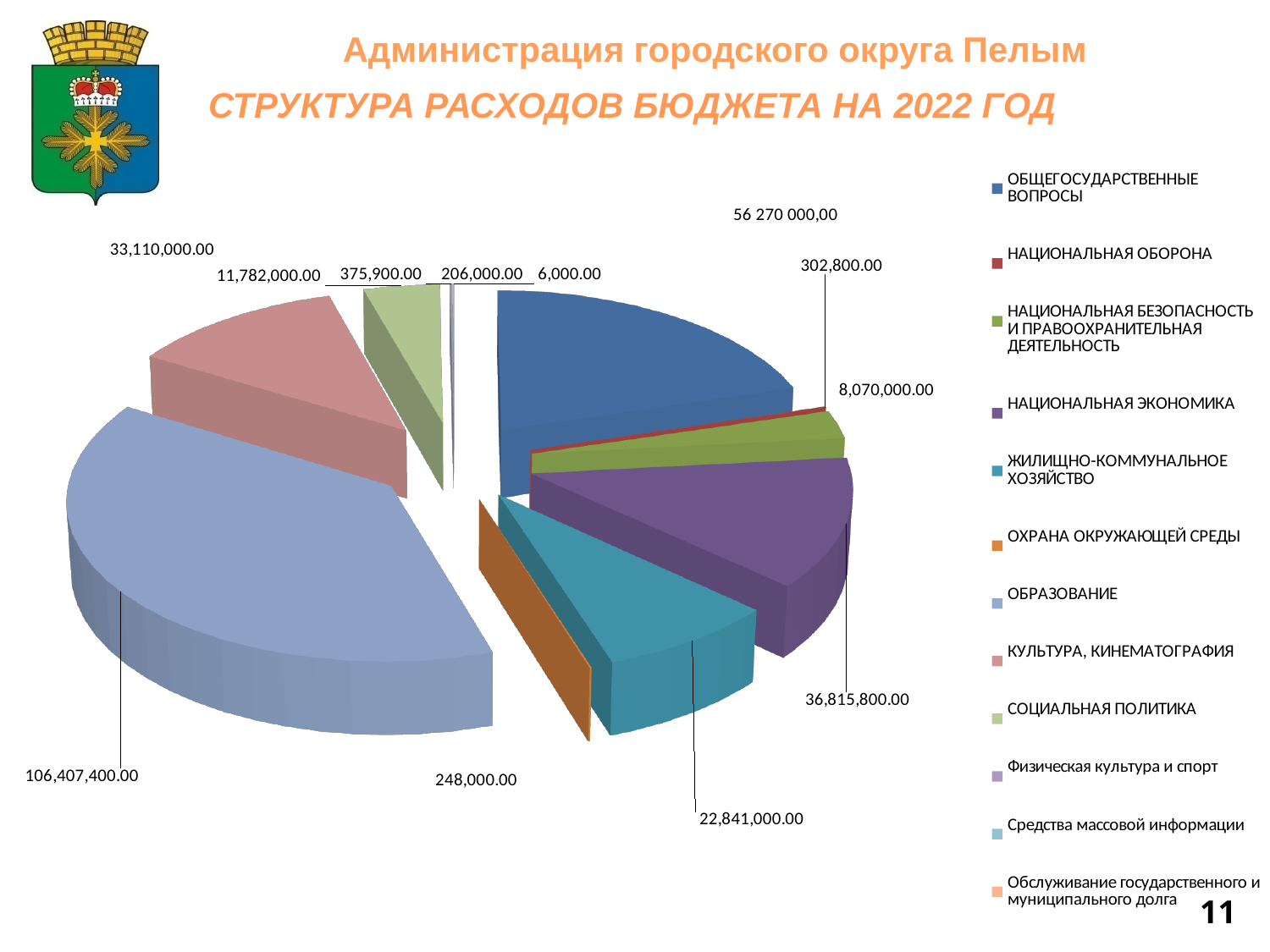
How many categories does the legend of the pie chart list? 12 Which is larger: НАЦИОНАЛЬНАЯ ЭКОНОМИКА or ЖИЛИЩНО-КОММУНАЛЬНОЕ ХОЗЯЙСТВО? НАЦИОНАЛЬНАЯ ЭКОНОМИКА What is the value shown for ЖИЛИЩНО-КОММУНАЛЬНОЕ ХОЗЯЙСТВО? 22,841,000.00 What is the value shown for ОБЩЕГОСУДАРСТВЕННЫЕ ВОПРОСЫ? 56 270 000,00 What is the difference between the values for НАЦИОНАЛЬНАЯ ЭКОНОМИКА and ЖИЛИЩНО-КОММУНАЛЬНОЕ ХОЗЯЙСТВО? 13,974,800.00 Which category has the largest slice of the pie? ОБРАЗОВАНИЕ What is the value shown for ОХРАНА ОКРУЖАЮЩЕЙ СРЕДЫ? 248,000.00 What kind of chart is shown on the slide? pie chart Which category has the smallest value in the pie chart? Обслуживание государственного и муниципального долга What is the value shown for ОБРАЗОВАНИЕ? 106,407,400.00 What is the value shown for НАЦИОНАЛЬНАЯ ОБОРОНА? 302,800.00 What is the value shown for НАЦИОНАЛЬНАЯ ЭКОНОМИКА? 36,815,800.00